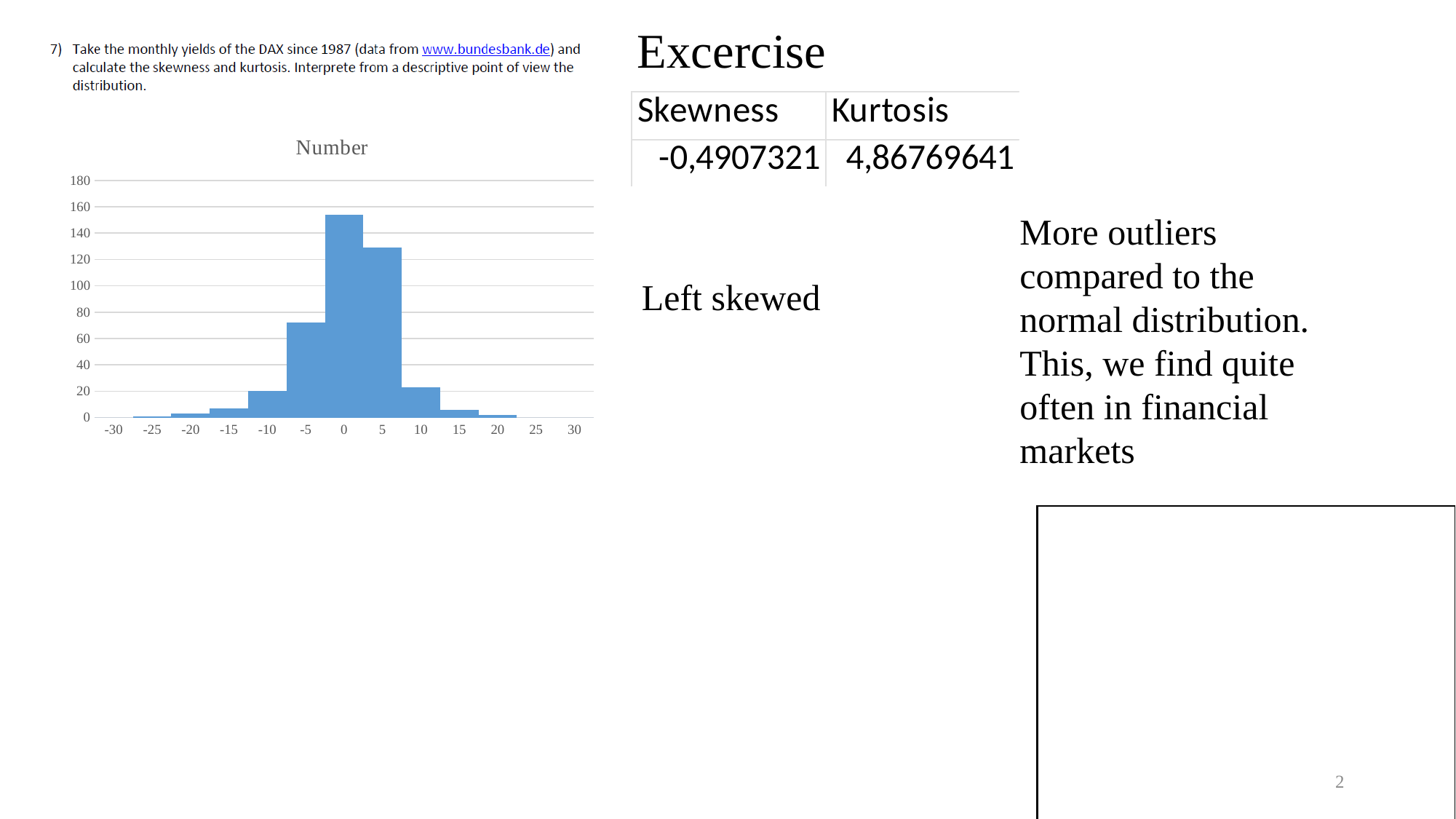
Which x-axis bin has the highest bar? 0 What colour are the bars in the chart? blue Is the value of the bar at -5 greater or less than 80? less Do the bar values rise or fall moving along the x axis from 0 to 20? fall Which bar is taller, the one at 0 or the one at 5? 0 Which bar is taller, the one at -5 or the one at 5? 5 Is the value of the bar at 10 greater or less than 40? less Is the value of the bar at 0 greater or less than 140? greater What kind of chart is shown on the slide? bar chart What is the title of the chart? Number